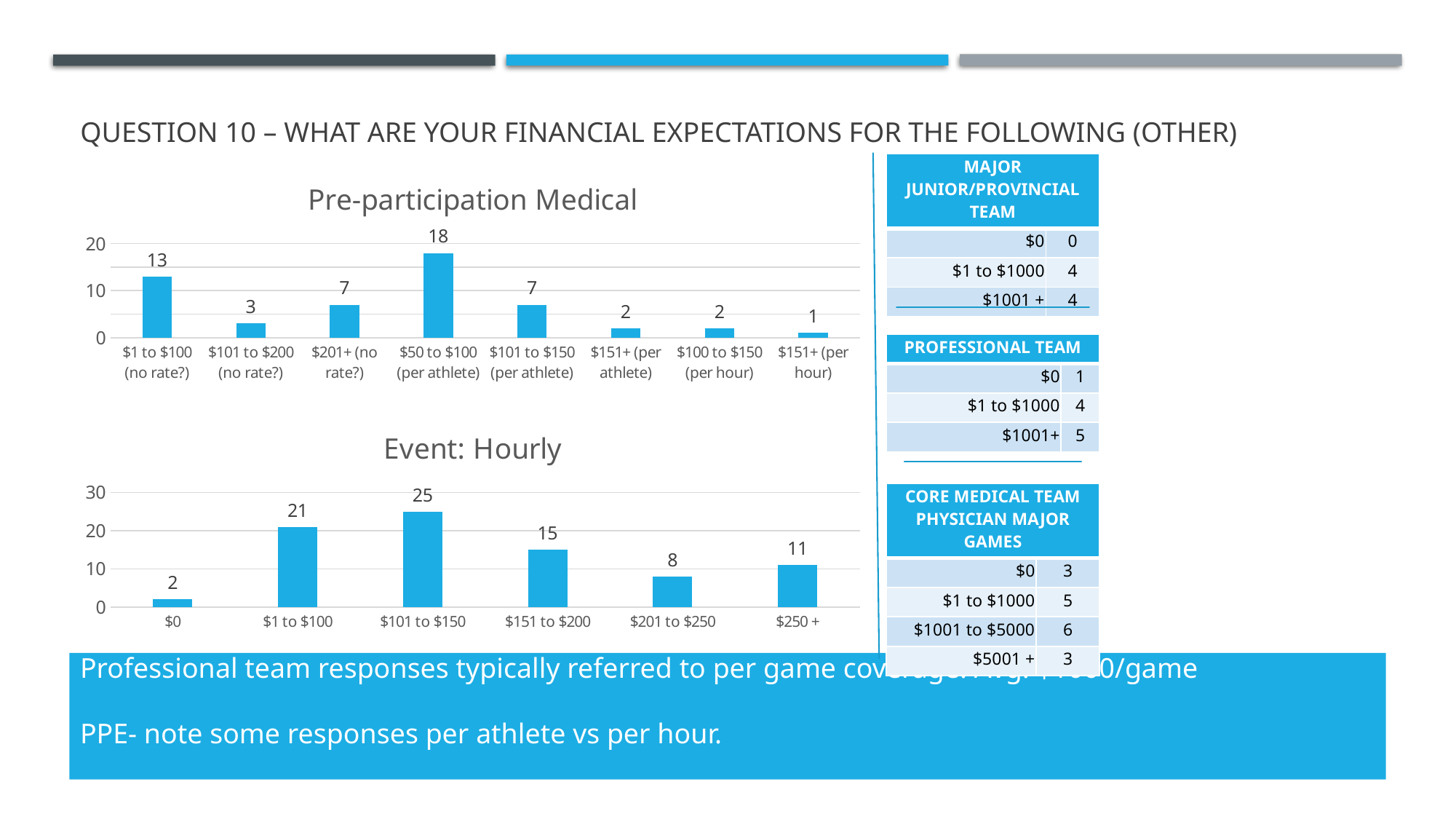
In the 'Event: Hourly' chart, what is the value for '$101 to $150'? 25 In the 'Pre-participation Medical' chart, how many categories are shown? 8 In the 'Pre-participation Medical' chart, which category has the lowest value? $151+ (per hour) In the 'Event: Hourly' chart, what is the difference between '$250 +' and '$201 to $250'? 3 In the 'Pre-participation Medical' chart, what is the difference between '$50 to $100 (per athlete)' and '$101 to $150 (per athlete)'? 11 In the 'Pre-participation Medical' chart, what is the value for '$1 to $100 (no rate?)'? 13 In the 'Event: Hourly' chart, which category has the highest value? $101 to $150 In the 'Pre-participation Medical' chart, what is the value for '$50 to $100 (per athlete)'? 18 In the 'Event: Hourly' chart, how many categories are shown? 6 What type of chart is the 'Event: Hourly' chart? Bar chart In the 'Event: Hourly' chart, is the value for '$1 to $100' greater or less than 20? greater In the 'Event: Hourly' chart, which is larger, '$1 to $100' or '$151 to $200'? $1 to $100